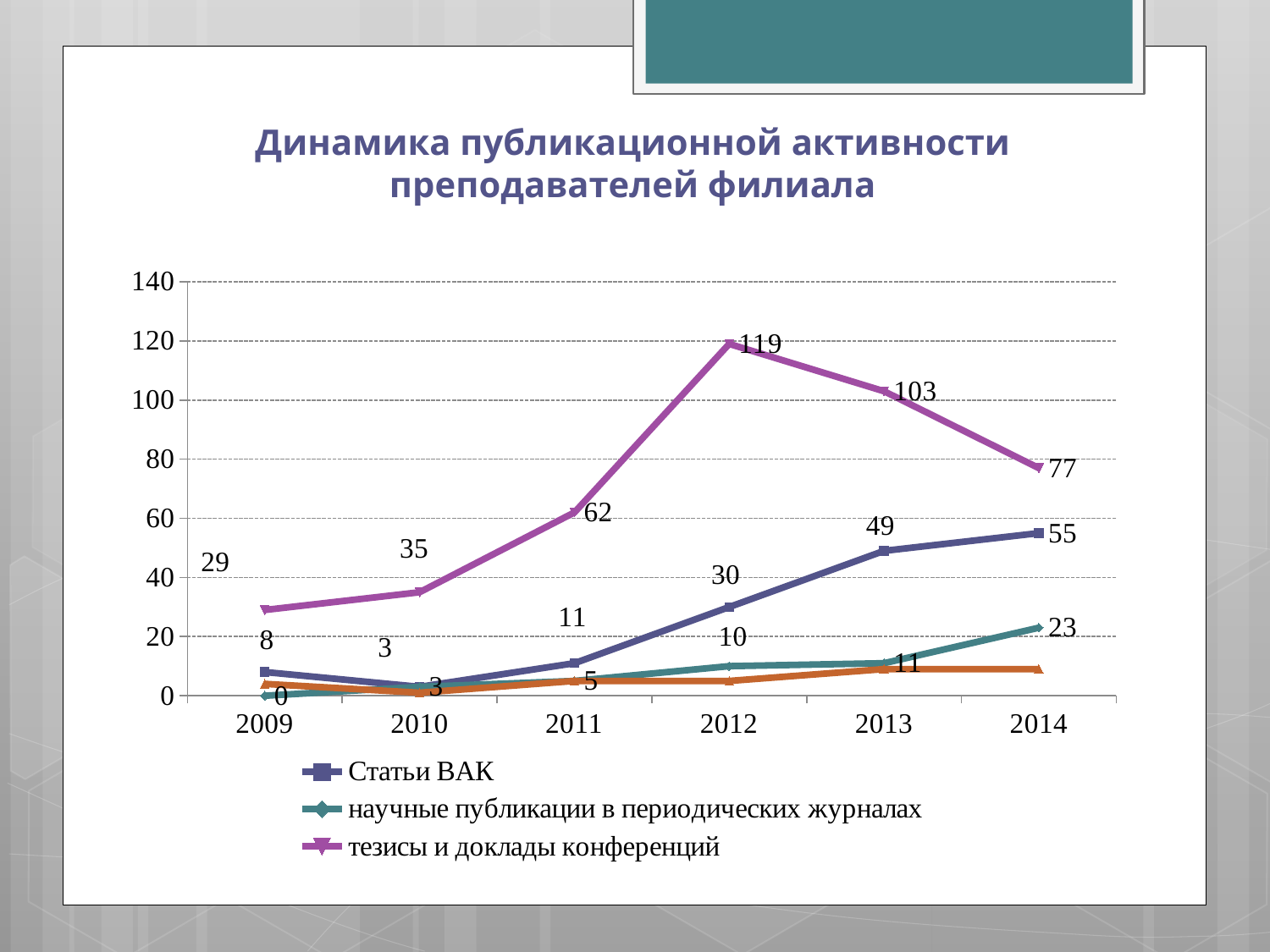
Is the value for тезисы и доклады конференций in 2011 greater or less than 80? less How many series does the legend list? 3 Do the values for Статьи ВАК rise or fall from 2010 to 2014? rise What is the value for тезисы и доклады конференций in 2012? 119 What kind of chart is shown on the slide? line chart What is the difference between the тезисы и доклады конференций values in 2012 and 2014? 42 In which year is the value for Статьи ВАК lowest? 2010 How many years are shown on the x axis? 6 In which year does тезисы и доклады конференций reach its highest value? 2012 What is the value for Статьи ВАК in 2014? 55 What is the title of the chart? Динамика публикационной активности преподавателей филиала In 2013, which is larger: Статьи ВАК or научные публикации в периодических журналах? Статьи ВАК